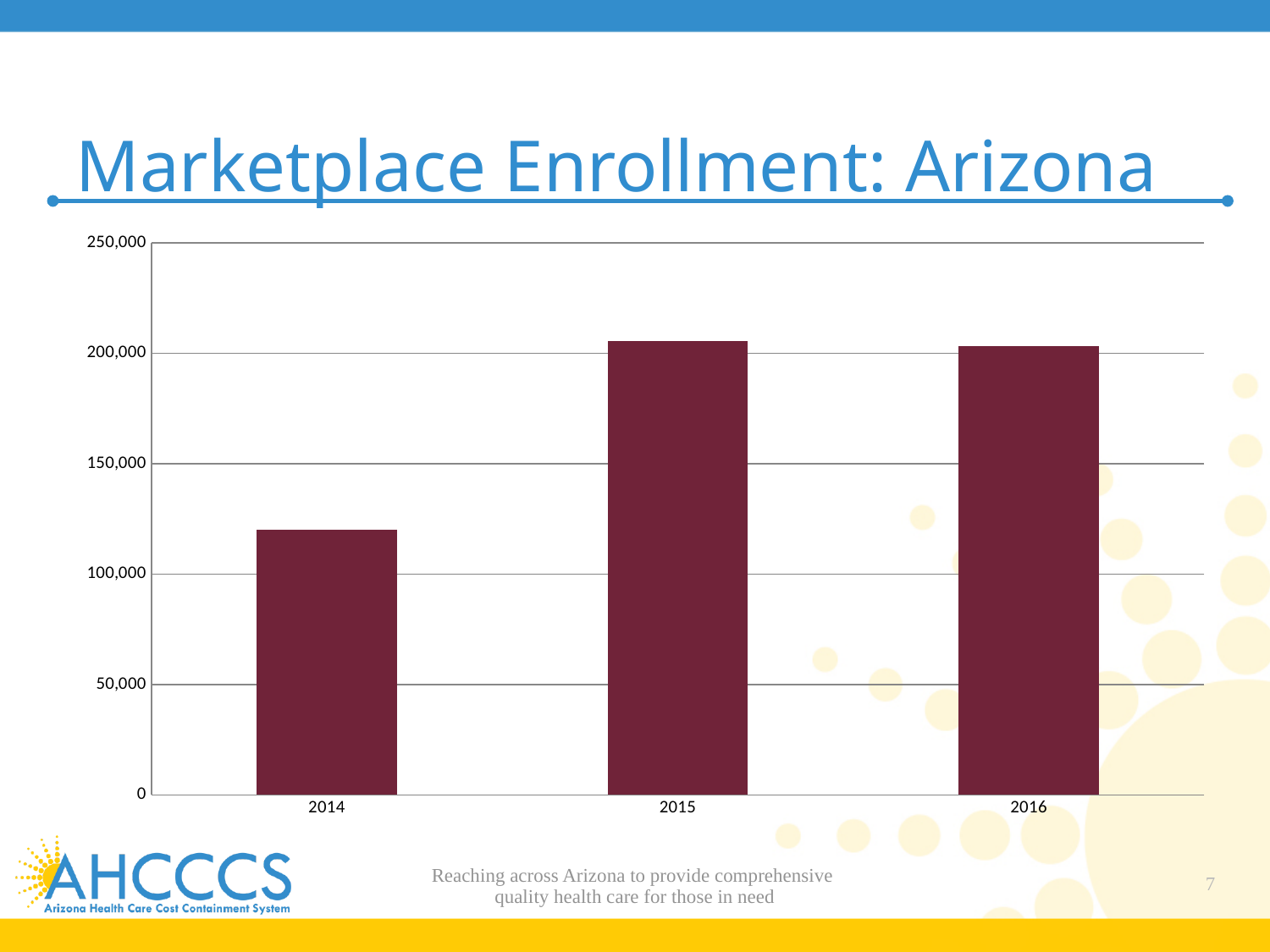
How many years are shown on the x axis of the chart? 3 Is the value for 2014 greater or less than 100,000? greater Which is larger, the value for 2014 or the value for 2015? 2015 What kind of chart is shown on the slide? bar chart Which year has the lowest enrollment in the chart? 2014 Is the value for 2016 greater or less than 250,000? less Is the value for 2014 greater or less than 150,000? less What is the highest value shown on the y axis of the chart? 250,000 What is the title of the chart? Marketplace Enrollment: Arizona Which is larger, the value for 2014 or the value for 2016? 2016